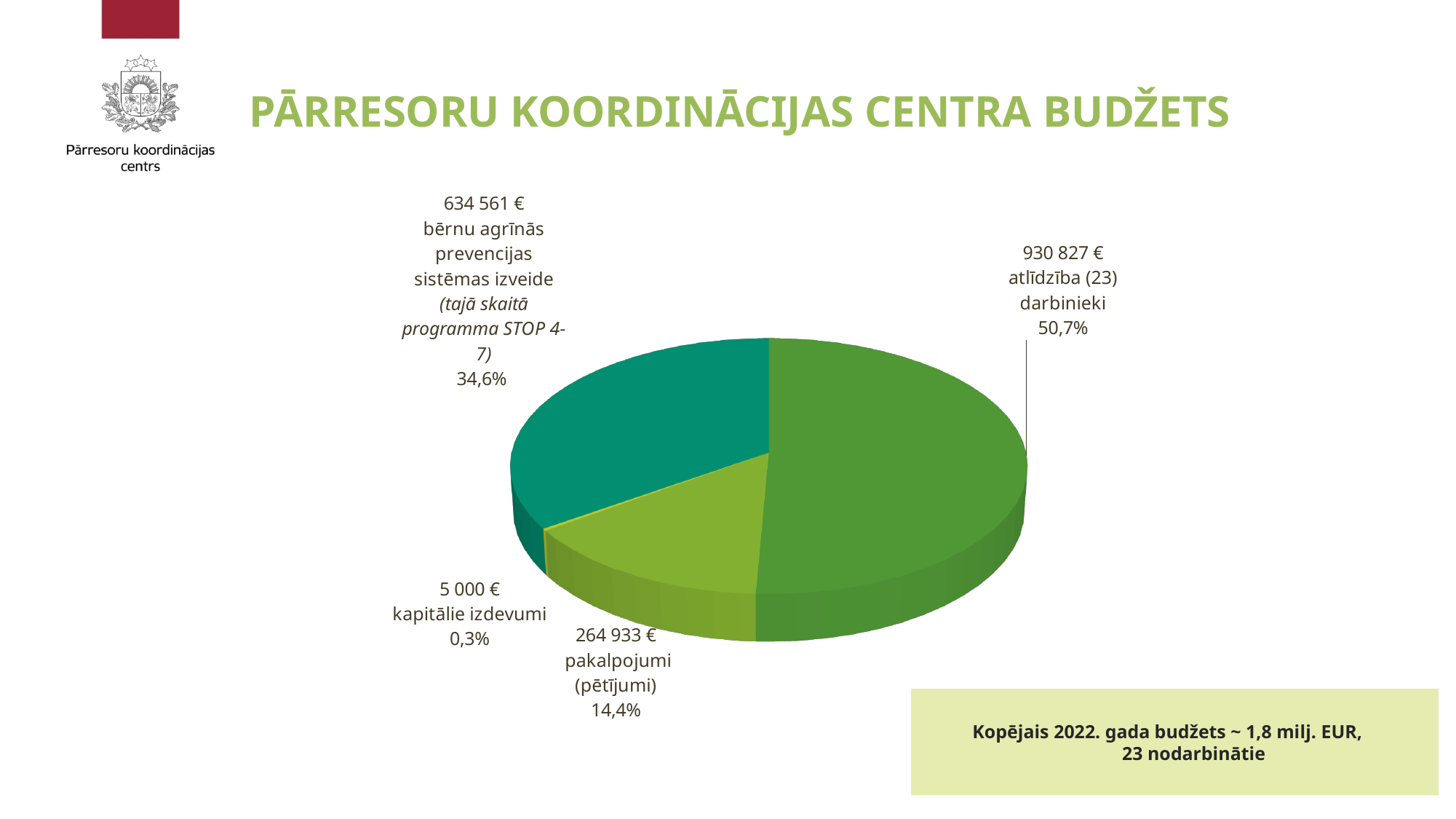
How many slices does the pie chart have? 4 What is the value for atlīdzība (23) darbinieki? 930 827 € What is the value for bērnu agrīnās prevencijas sistēmas izveide? 634 561 € What share of the pie does atlīdzība (23) darbinieki represent? 50,7% What is the value for kapitālie izdevumi? 5 000 € Which is larger, pakalpojumi (pētījumi) or bērnu agrīnās prevencijas sistēmas izveide? bērnu agrīnās prevencijas sistēmas izveide What is the title of the slide containing the chart? PĀRRESORU KOORDINĀCIJAS CENTRA BUDŽETS What kind of chart is shown on the slide? pie chart What is the value for pakalpojumi (pētījumi)? 264 933 € What share of the pie does bērnu agrīnās prevencijas sistēmas izveide represent? 34,6% Which category has the largest slice of the pie? atlīdzība (23) darbinieki Which category has the smallest slice of the pie? kapitālie izdevumi